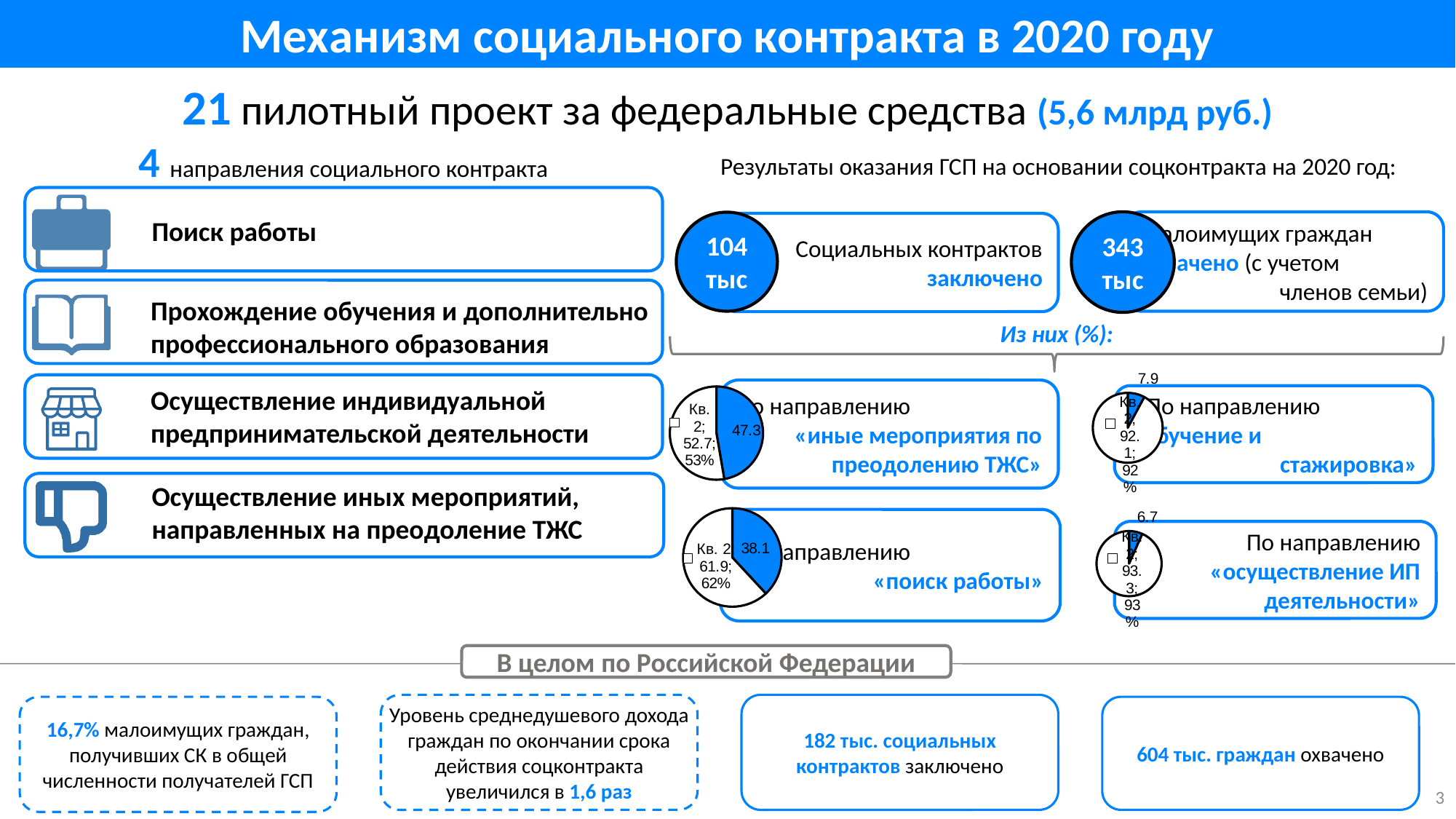
In the pie chart next to «осуществление ИП деятельности», which slice is the smallest? the blue slice (6.7) In the pie chart next to «иные мероприятия по преодолению ТЖС», what value is shown for the blue slice? 47.3 In the pie chart next to «иные мероприятия по преодолению ТЖС», what value is shown for the slice labelled Кв. 2? 52.7 In the pie chart next to «поиск работы», what is the difference between the Кв. 2 slice (61.9) and the blue slice (38.1)? 23.8 In the pie chart next to «обучение и стажировка», which slice is larger: the blue slice or the Кв. 2 slice? Кв. 2 What kind of chart is used next to the «иные мероприятия по преодолению ТЖС» box? pie chart In the pie chart next to «осуществление ИП деятельности», what value is shown for the Кв. 2 slice? 93.3 How many slices does the pie chart next to «поиск работы» have? 2 In the pie chart next to «поиск работы», what value is shown for the blue slice? 38.1 In the pie chart next to «поиск работы», what percentage share is printed for the Кв. 2 slice? 62% In the pie chart next to «иные мероприятия по преодолению ТЖС», what is the difference between the Кв. 2 slice (52.7) and the blue slice (47.3)? 5.4 In the pie chart next to «обучение и стажировка», what value is shown for the small blue slice? 7.9